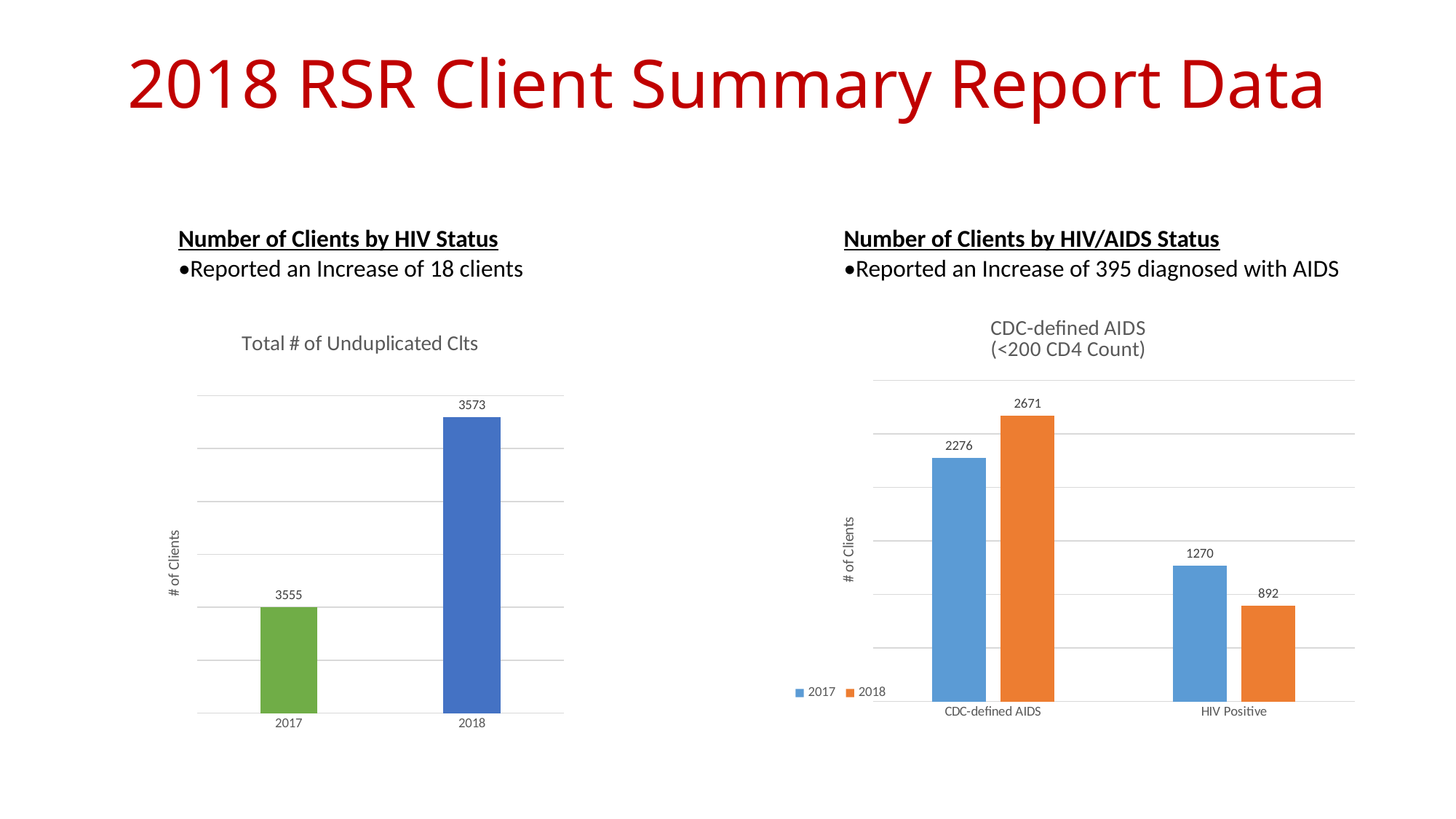
In the 'CDC-defined AIDS (<200 CD4 Count)' chart, what is the 2017 value for HIV Positive? 1270 In the 'CDC-defined AIDS (<200 CD4 Count)' chart, what colour are the 2018 bars? orange In the 'Total # of Unduplicated Clts' chart, how many bars are plotted? 2 In the 'CDC-defined AIDS (<200 CD4 Count)' chart, which bar has the lowest value? HIV Positive, 2018 (892) In the 'Total # of Unduplicated Clts' chart, what is the value for 2017? 3555 In the 'CDC-defined AIDS (<200 CD4 Count)' chart, what is the 2018 value for CDC-defined AIDS? 2671 In the 'Total # of Unduplicated Clts' chart, what is the value for 2018? 3573 In the 'CDC-defined AIDS (<200 CD4 Count)' chart, what is the difference between the 2018 and 2017 values for CDC-defined AIDS? 395 In the 'CDC-defined AIDS (<200 CD4 Count)' chart, which is larger for HIV Positive: the 2017 value or the 2018 value? 2017 How many series does the legend of the 'CDC-defined AIDS (<200 CD4 Count)' chart list? 2 In the 'Total # of Unduplicated Clts' chart, what is the difference between the 2018 and 2017 values? 18 What kind of chart is the 'CDC-defined AIDS (<200 CD4 Count)' chart? bar chart